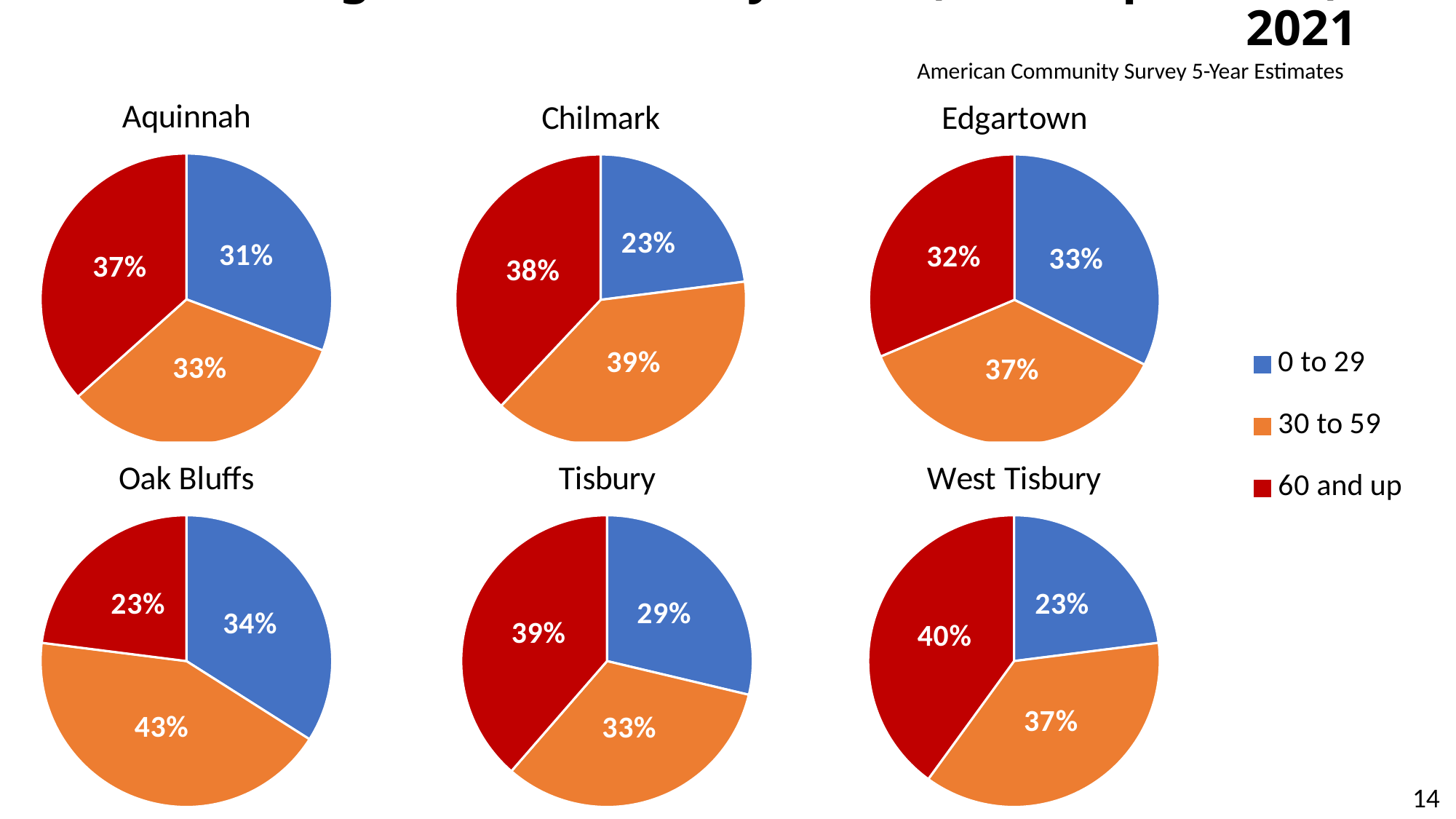
How many pie charts are on the slide? 6 In the Tisbury pie chart, what is the difference between the 60 and up share and the 0 to 29 share? 10% In the West Tisbury pie chart, what share is the 60 and up group? 40% Which colour represents the 30 to 59 group in the legend? Orange In the Oak Bluffs pie chart, which is larger, the 0 to 29 share or the 60 and up share? 0 to 29 In the Aquinnah pie chart, what share is the 60 and up group? 37% In the Oak Bluffs pie chart, which age group has the largest share? 30 to 59 In the Chilmark pie chart, what share is the 0 to 29 group? 23% In the West Tisbury pie chart, which age group has the smallest share? 0 to 29 How many age groups does the legend list? 3 In the Edgartown pie chart, what share is the 30 to 59 group? 37% What kind of chart is used for each town on this slide? Pie chart